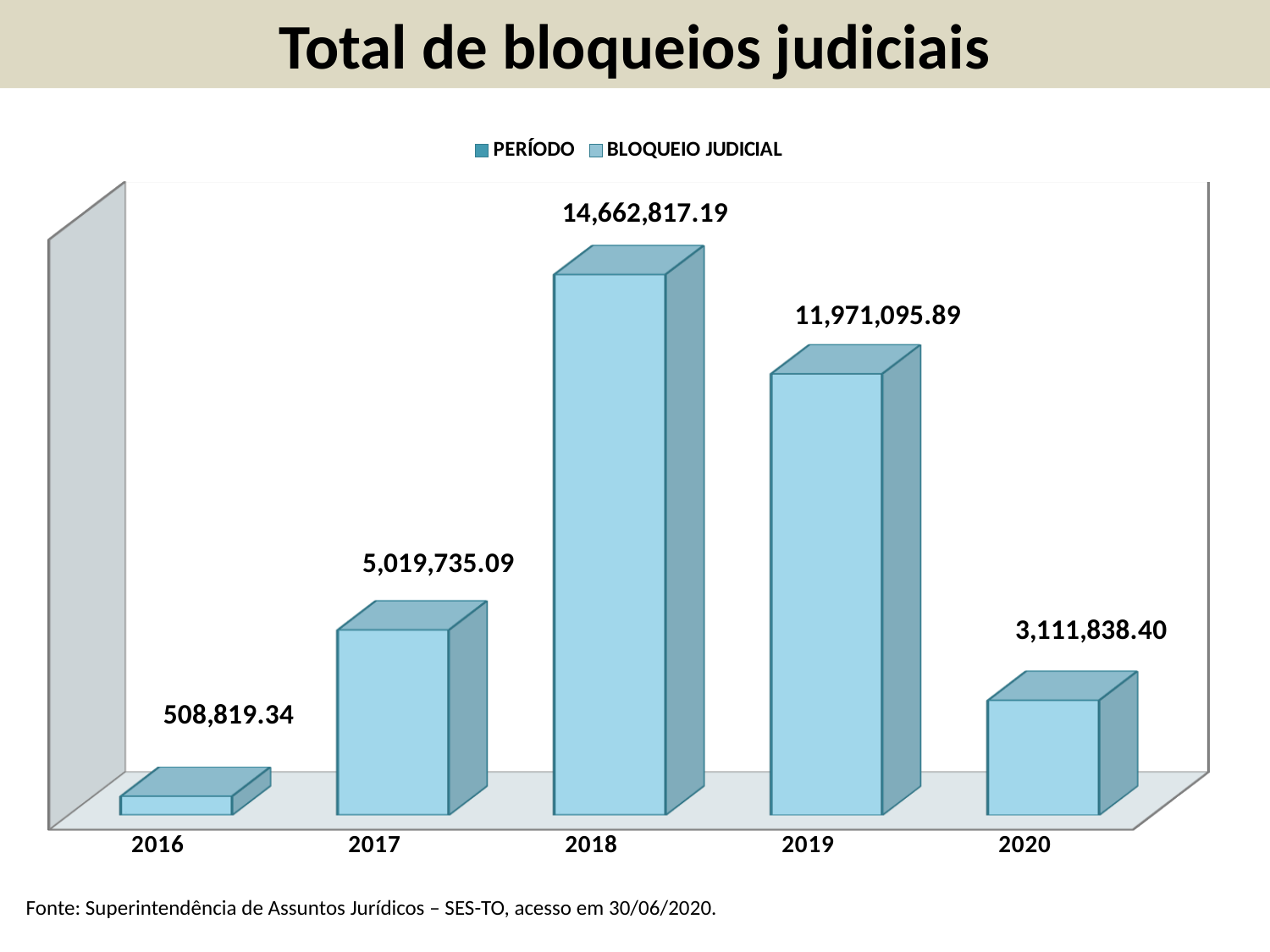
What is the difference between the values for 2017 and 2016? 4,510,915.75 What is the title of the chart? Total de bloqueios judiciais What kind of chart is shown? Bar chart Which is larger, the value for 2019 or the value for 2020? 2019 How many years are shown on the x axis? 5 Which year has the highest value? 2018 Which year has the lowest value? 2016 What is the value for 2016? 508,819.34 What is the difference between the values for 2018 and 2019? 2,691,721.30 What is the value for 2020? 3,111,838.40 What is the value for 2018? 14,662,817.19 What is the value for 2017? 5,019,735.09